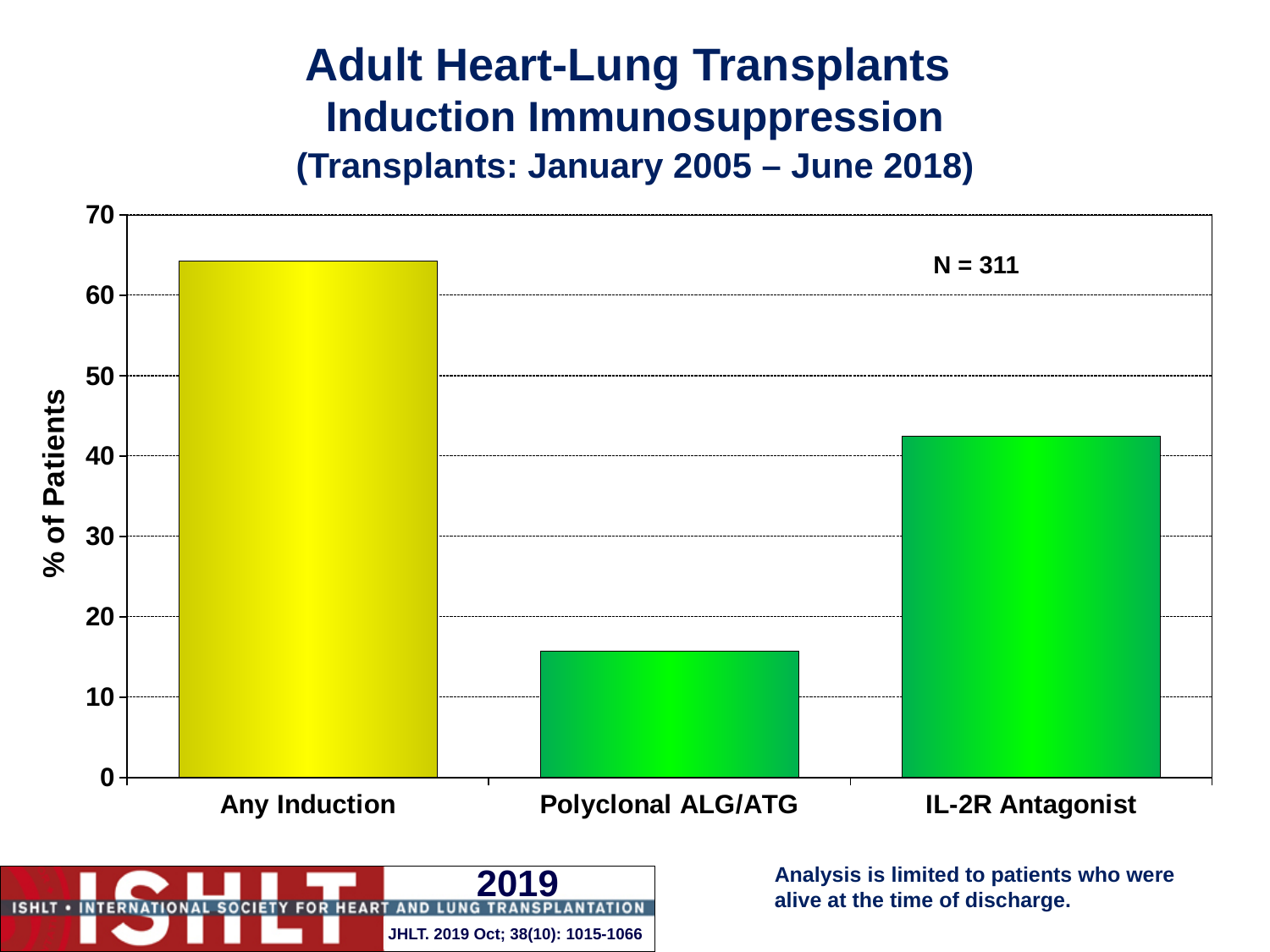
Is the value for Any Induction greater or less than 60? greater Is the value for Polyclonal ALG/ATG greater or less than 20? less Which category has the lowest % of Patients? Polyclonal ALG/ATG Which category has the highest % of Patients? Any Induction What kind of chart is shown on the slide? bar chart Which is larger, the value for IL-2R Antagonist or the value for Polyclonal ALG/ATG? IL-2R Antagonist What is the label of the y axis? % of Patients Is the value for IL-2R Antagonist greater or less than 50? less How many categories are shown on the x axis of the chart? 3 What is the value of N shown on the chart? 311 Which is larger, the value for Any Induction or the value for IL-2R Antagonist? Any Induction